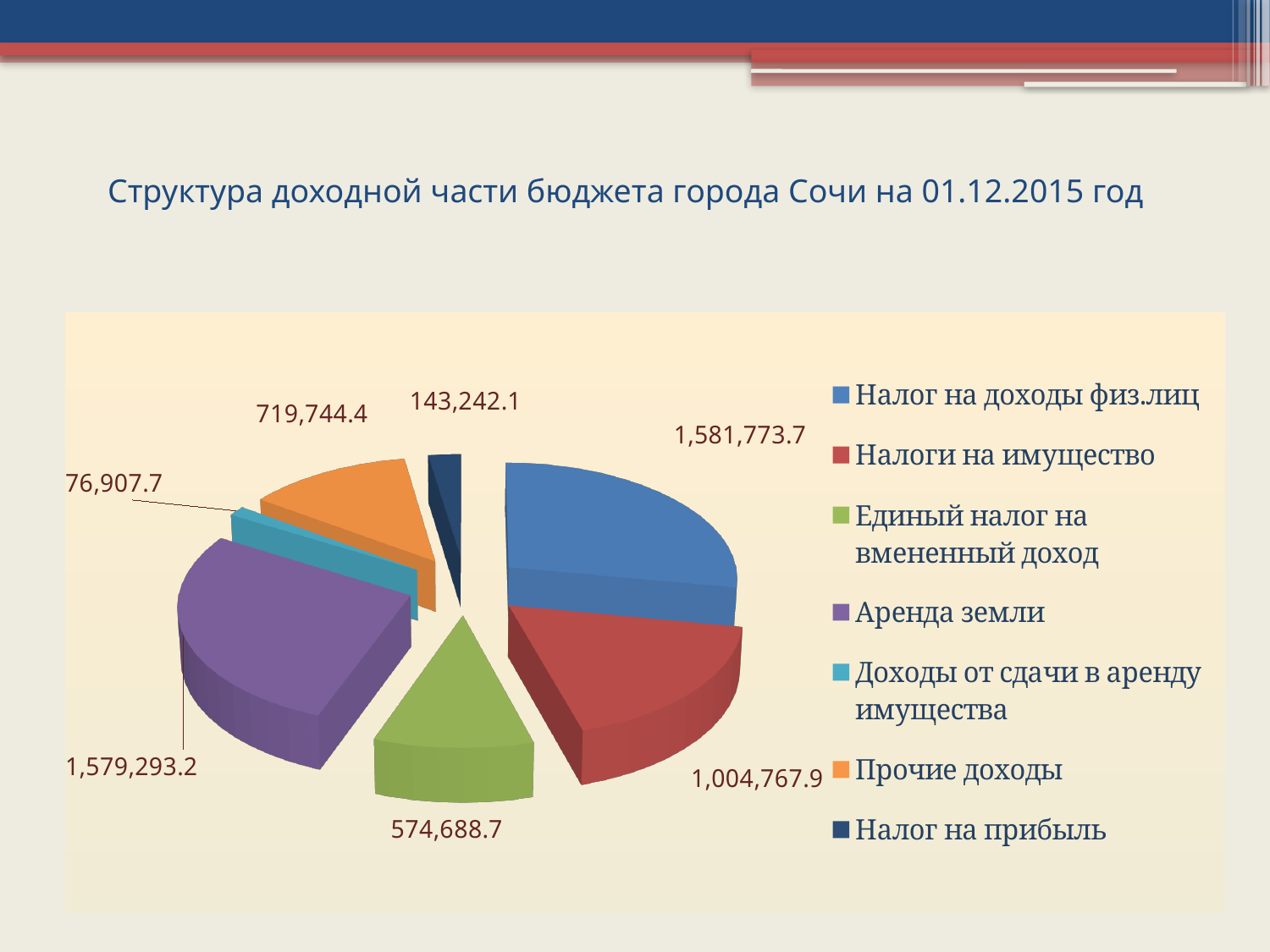
What is the value for Прочие доходы? 719,744.4 What is the value for Налог на прибыль? 143,242.1 What type of chart is shown on the slide? Pie chart What is the value for Налоги на имущество? 1,004,767.9 Which is larger, Налоги на имущество or Прочие доходы? Налоги на имущество Which category has the smallest value? Доходы от сдачи в аренду имущества What is the value for Налог на доходы физ.лиц? 1,581,773.7 How many categories does the legend list? 7 What is the value for Единый налог на вмененный доход? 574,688.7 What is the value for Аренда земли? 1,579,293.2 What is the value for Доходы от сдачи в аренду имущества? 76,907.7 What is the difference between Налоги на имущество and Единый налог на вмененный доход? 430,079.2